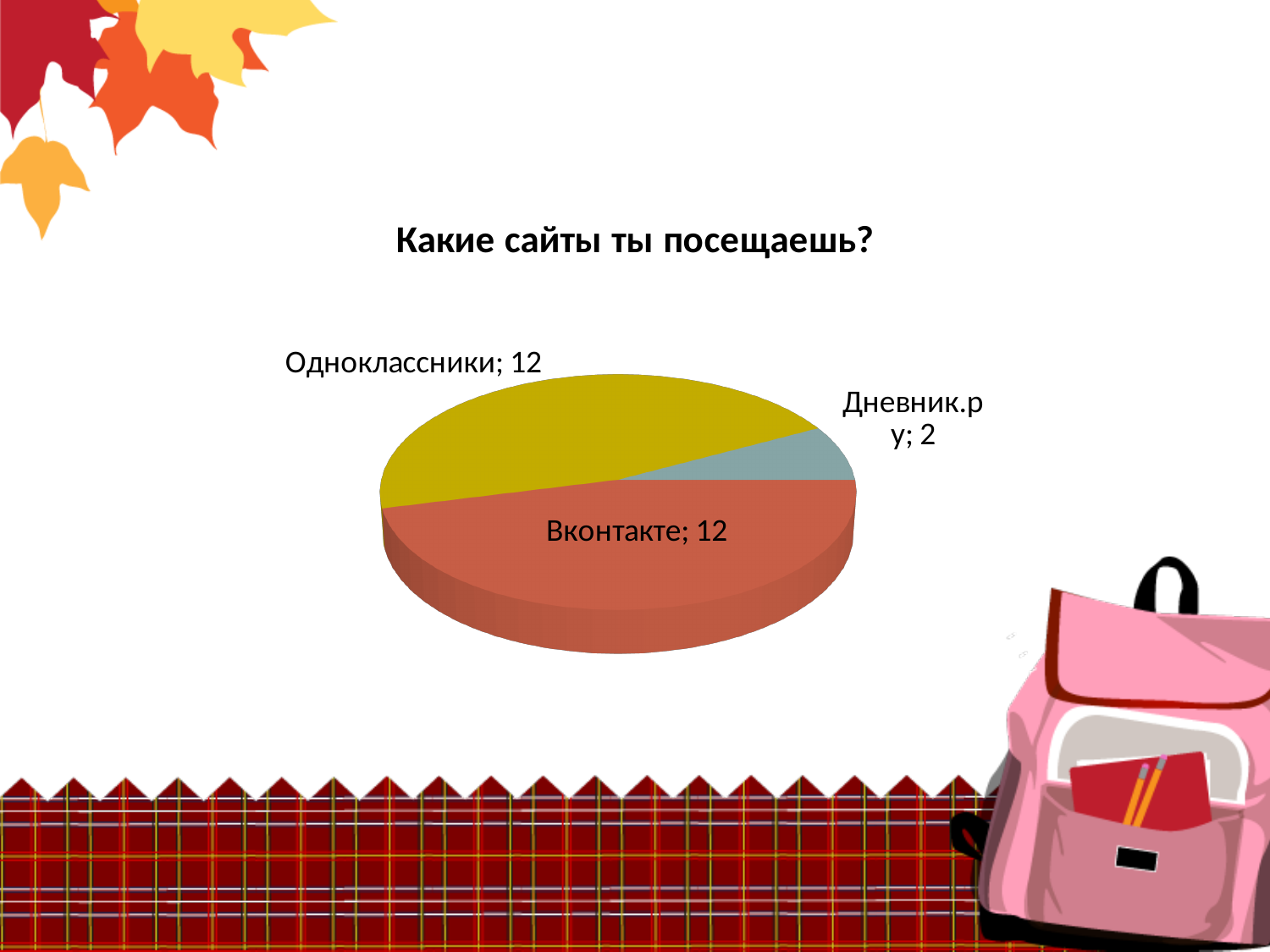
Which is larger, the value for Одноклассники or the value for Дневник.ру? Одноклассники What is the value for Вконтакте? 12 What is the difference between the values for Вконтакте and Дневник.ру? 10 What is the value for Одноклассники? 12 Which site has the smallest value in the pie chart? Дневник.ру What is the difference between the values for Одноклассники and Дневник.ру? 10 What type of chart is shown on the slide? Pie chart Which colour is the Вконтакте slice? Red What is the value for Дневник.ру? 2 How many categories (slices) does the pie chart have? 3 What is the title of the chart? Какие сайты ты посещаешь? What is the total of all values shown in the pie chart? 26